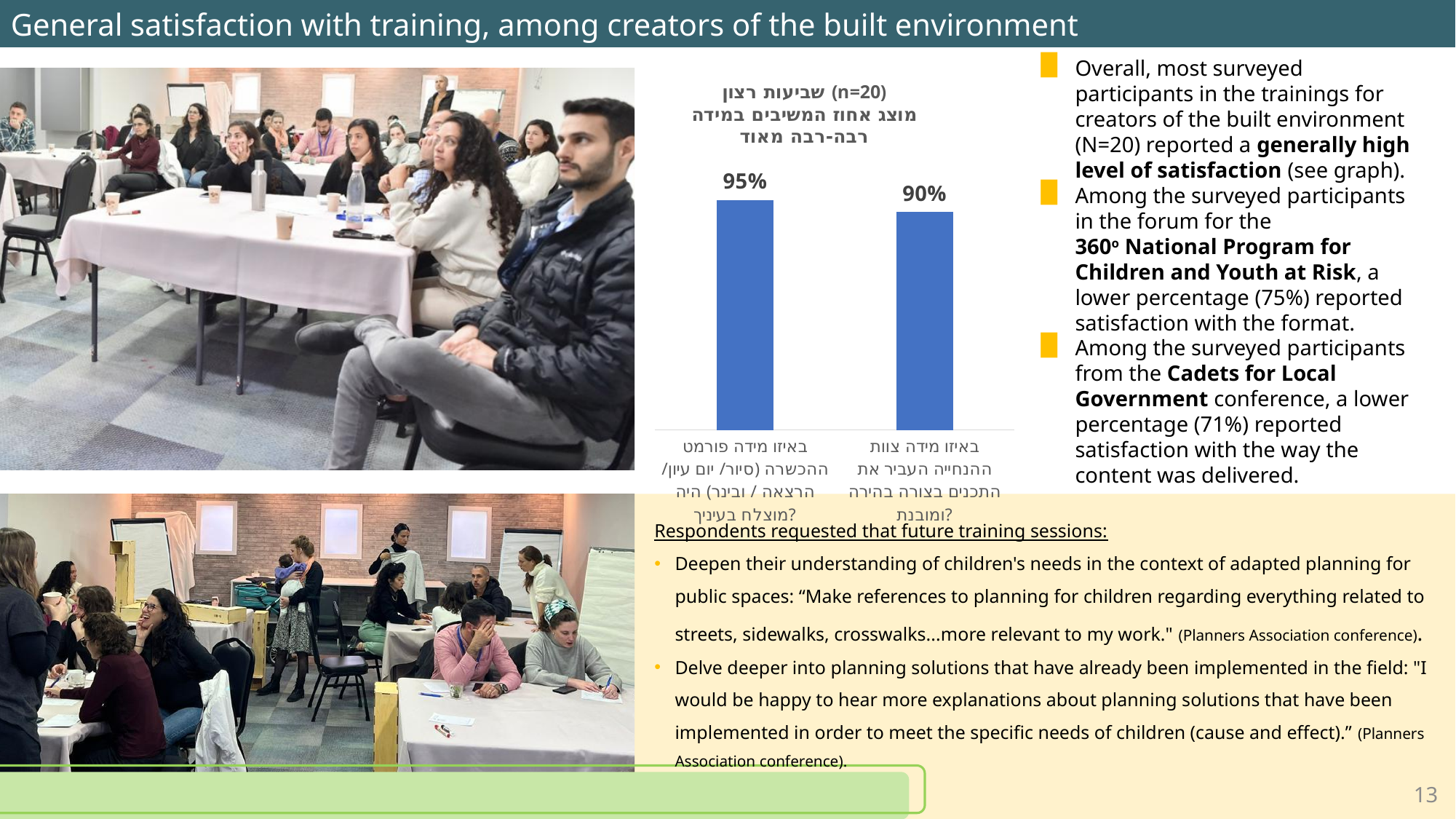
What is the difference between the two bar values in the chart? 5% What is the value of the right bar in the chart (the question about the facilitation team conveying content clearly)? 90% Do the values fall or rise from the left bar to the right bar? fall Which category has the lowest value in the chart? the right bar (facilitation team conveyed content clearly) What type of chart is shown on the slide? bar chart What is the value of the left bar in the chart (the question about the training format)? 95% How many bars does the chart show? 2 What sample size (n) is stated in the chart title? n=20 Which bar in the chart is higher, the left one or the right one? the left one What colour are the bars in the chart? blue